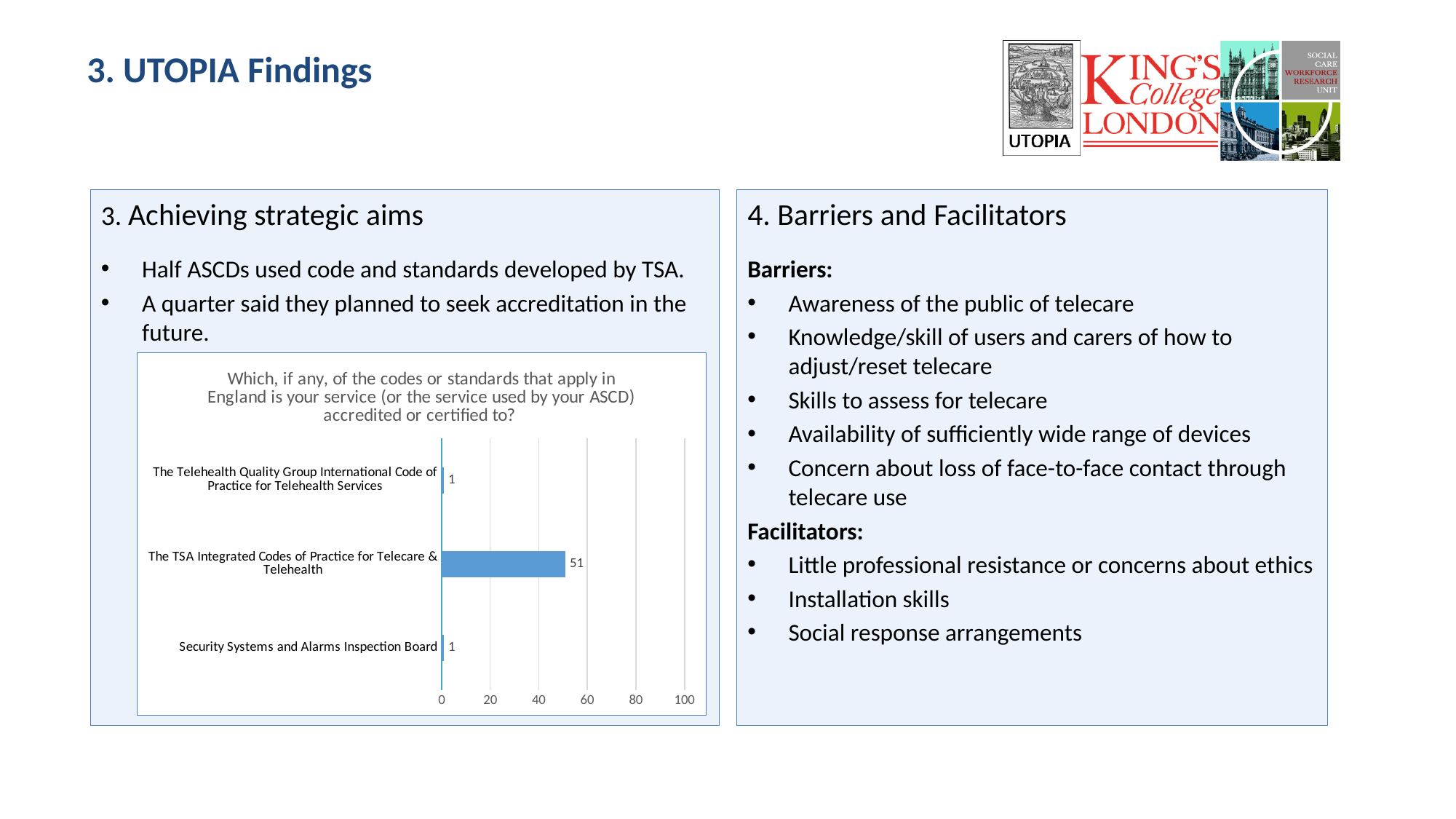
How many categories are shown in the chart? 3 What is the title of the chart? Which, if any, of the codes or standards that apply in England is your service (or the service used by your ASCD) accredited or certified to? Is the value for Security Systems and Alarms Inspection Board greater or less than 20? less Is the value for The TSA Integrated Codes of Practice for Telecare & Telehealth greater or less than 40? greater Which category has the highest value? The TSA Integrated Codes of Practice for Telecare & Telehealth What is the maximum value shown on the chart's horizontal axis? 100 What kind of chart is shown on the slide? bar chart What is the value for The Telehealth Quality Group International Code of Practice for Telehealth Services? 1 What is the difference between the value for The TSA Integrated Codes of Practice for Telecare & Telehealth and the value for Security Systems and Alarms Inspection Board? 50 Which is larger: the value for The TSA Integrated Codes of Practice for Telecare & Telehealth or the value for The Telehealth Quality Group International Code of Practice for Telehealth Services? The TSA Integrated Codes of Practice for Telecare & Telehealth What is the value for The TSA Integrated Codes of Practice for Telecare & Telehealth? 51 What is the value for Security Systems and Alarms Inspection Board? 1